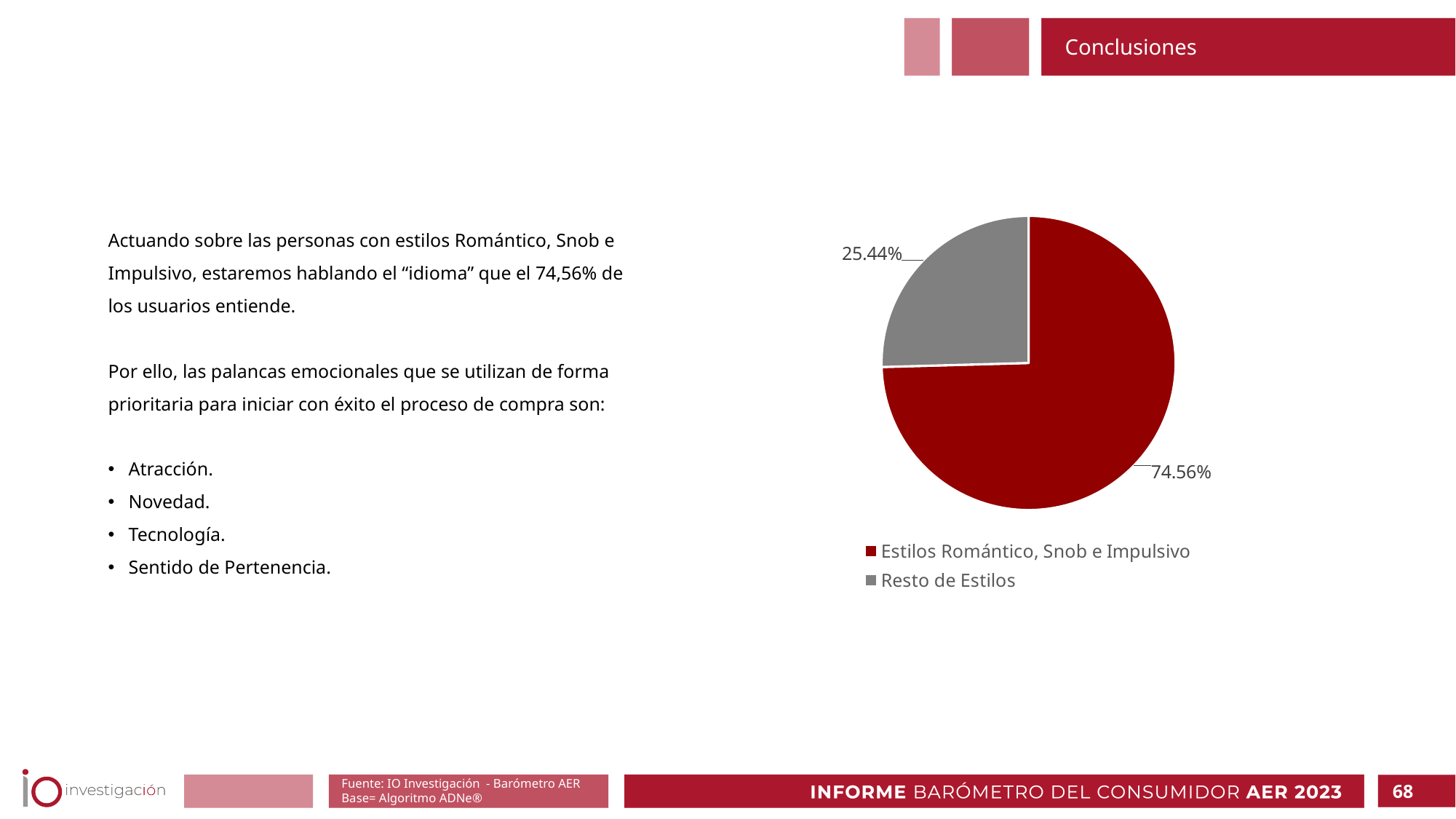
How many entries does the legend list? 2 What share of the pie does Resto de Estilos represent? 25.44% What is the value for Resto de Estilos? 25.44% What is the difference between the Estilos Romántico, Snob e Impulsivo slice and the Resto de Estilos slice? 49.12% Which slice is the largest? Estilos Romántico, Snob e Impulsivo How many slices does the pie chart have? 2 Which is larger, Estilos Romántico, Snob e Impulsivo or Resto de Estilos? Estilos Romántico, Snob e Impulsivo What kind of chart is shown on the slide? Pie chart What colour is the Resto de Estilos slice? Grey What is the value for Estilos Romántico, Snob e Impulsivo? 74.56% Which slice is the smallest? Resto de Estilos What colour is the Estilos Romántico, Snob e Impulsivo slice? Dark red